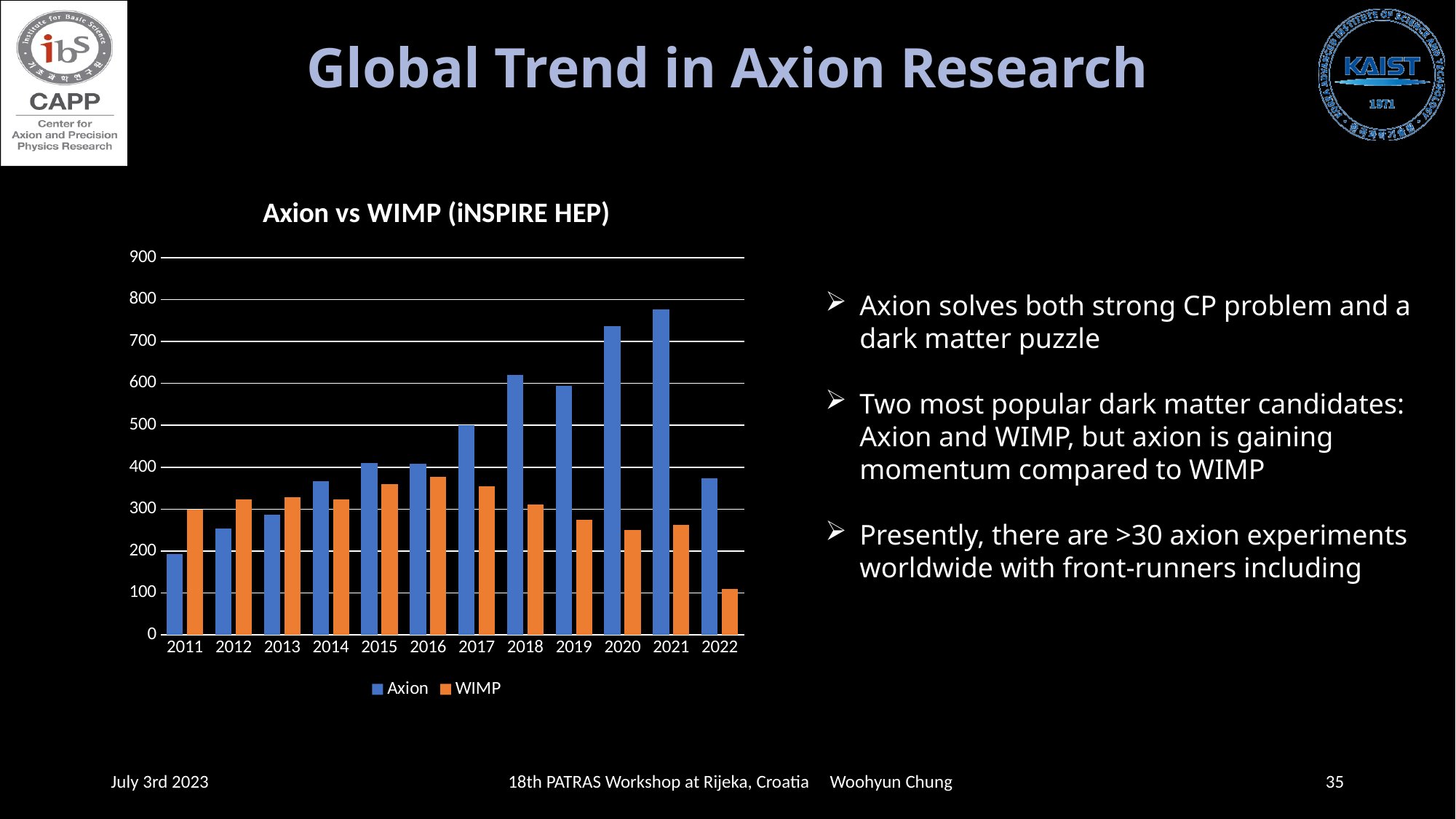
How many series does the chart's legend list? 2 How many years are shown on the x axis of the chart? 12 In which year is the WIMP value lowest? 2022 In which year is the Axion value lowest? 2011 What is the title of the chart? Axion vs WIMP (iNSPIRE HEP) In 2018, which is larger, the Axion value or the WIMP value? Axion In 2011, which is larger, the Axion value or the WIMP value? WIMP Is the WIMP value for 2022 greater or less than 200? less Is the Axion value for 2021 greater or less than 700? greater What kind of chart is shown on the slide? bar chart In which year is the Axion value highest? 2021 Is the WIMP value for 2019 greater or less than 300? less